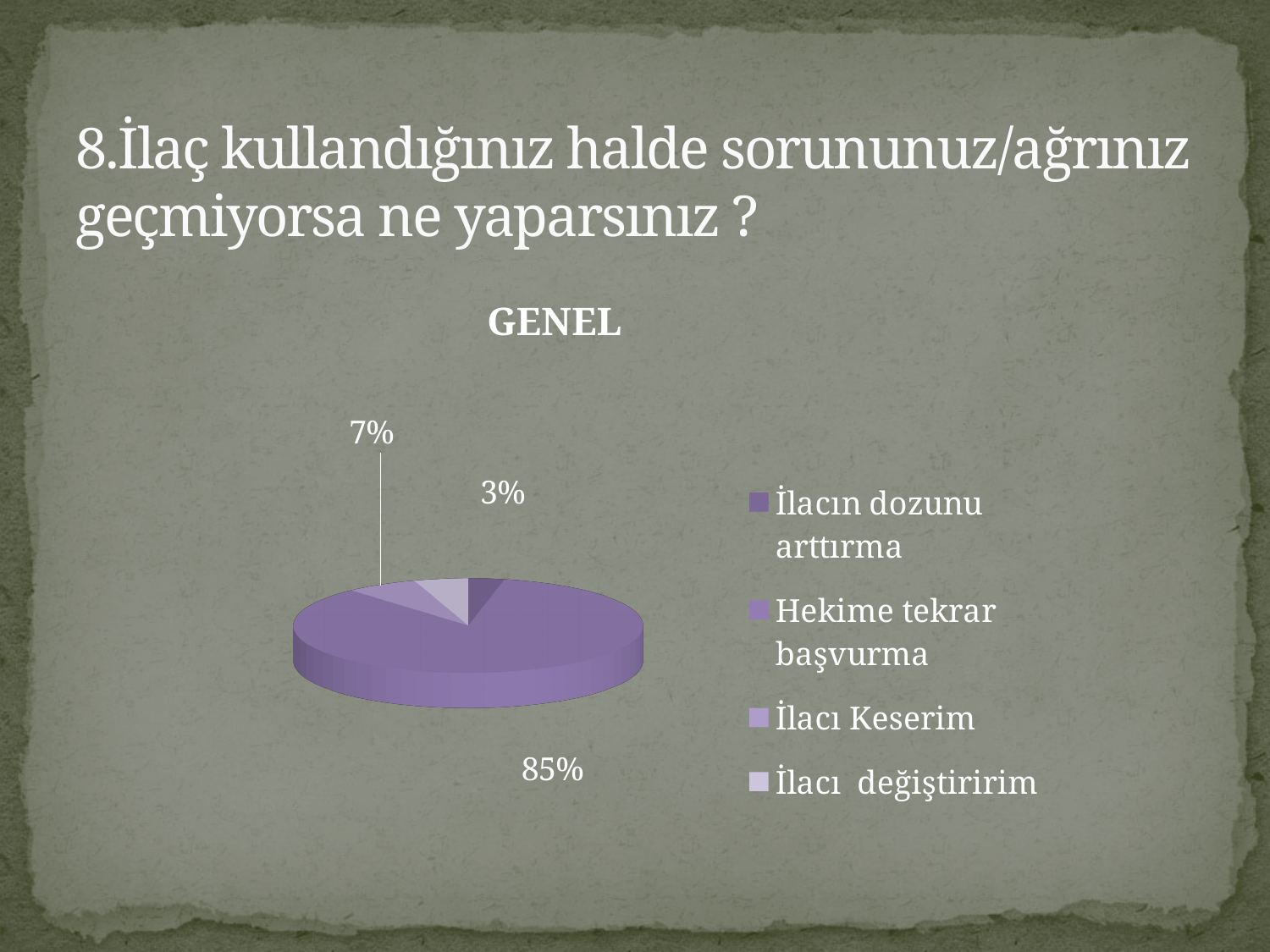
Is the share for Hekime tekrar başvurma greater or less than 50%? greater Which legend entry is listed first in the chart's legend? İlacın dozunu arttırma What is the title of the chart? GENEL How many categories does the legend of the pie chart list? 4 Which category has the largest share of the pie? Hekime tekrar başvurma What kind of chart is shown on the slide? pie chart Which is larger, the slice for Hekime tekrar başvurma or the slice for İlacın dozunu arttırma? Hekime tekrar başvurma What share of the pie does Hekime tekrar başvurma have? 85% What percentage is shown for the İlacı Keserim slice? 7% What is the difference between the 85% slice and the 7% slice? 78 percentage points What percentage is shown for the largest slice of the pie? 85%